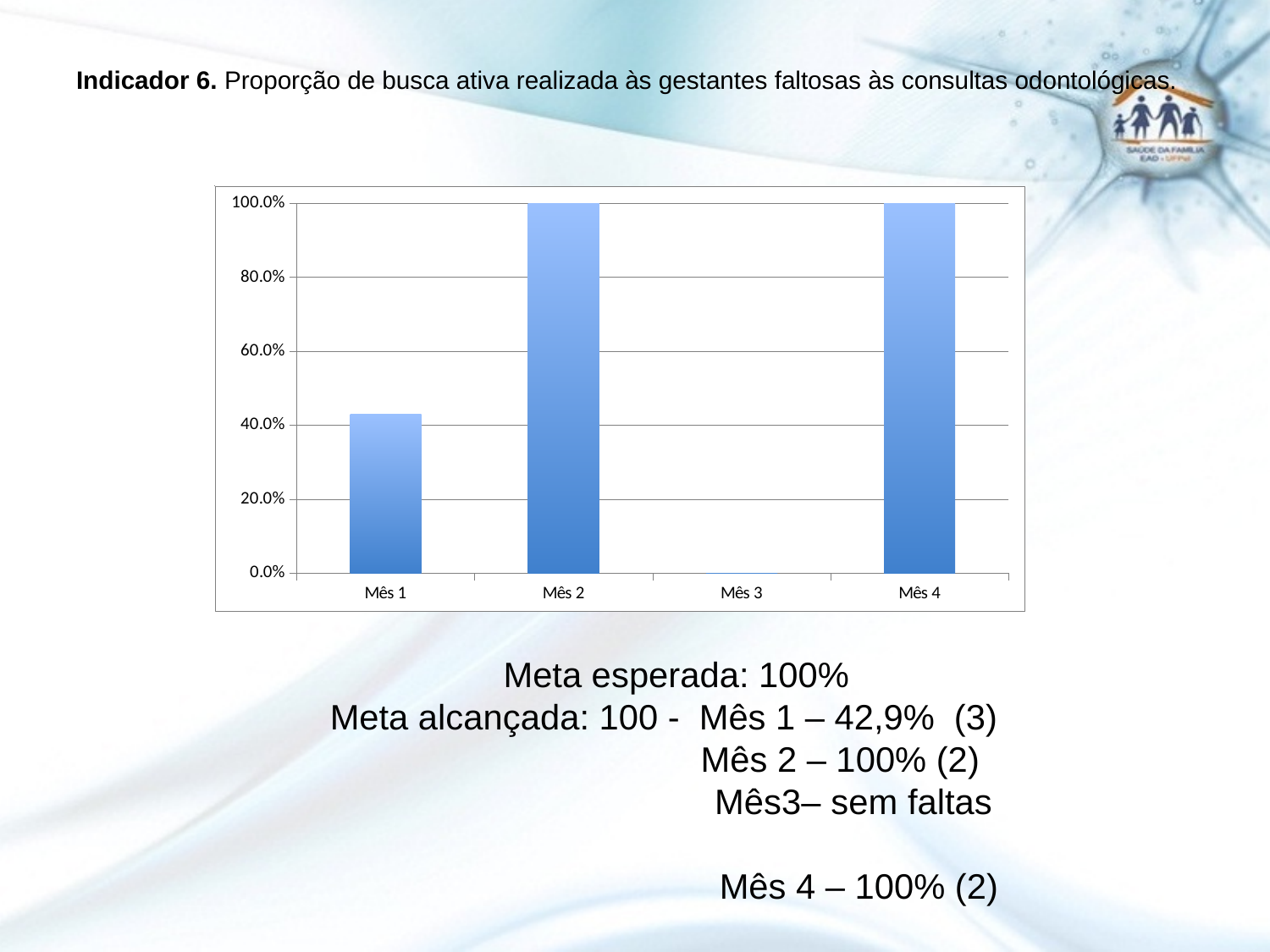
What is the value for Mês 2 in the chart? 100.0% What is the highest tick value shown on the y axis of the chart? 100.0% Is the value for Mês 1 greater or less than 60.0%? less Which is larger, the value for Mês 1 or the value for Mês 2? Mês 2 Is the value for Mês 1 greater or less than 20.0%? greater Which month has no bar in the chart? Mês 3 According to the slide, what proportion was reached in Mês 1? 42,9% How many months (categories) are shown on the x axis of the chart? 4 What kind of chart is shown on the slide? bar chart What is the expected target (meta esperada) stated on the slide? 100% What is the value for Mês 4 in the chart? 100.0% Which month has the lowest value in the chart? Mês 3